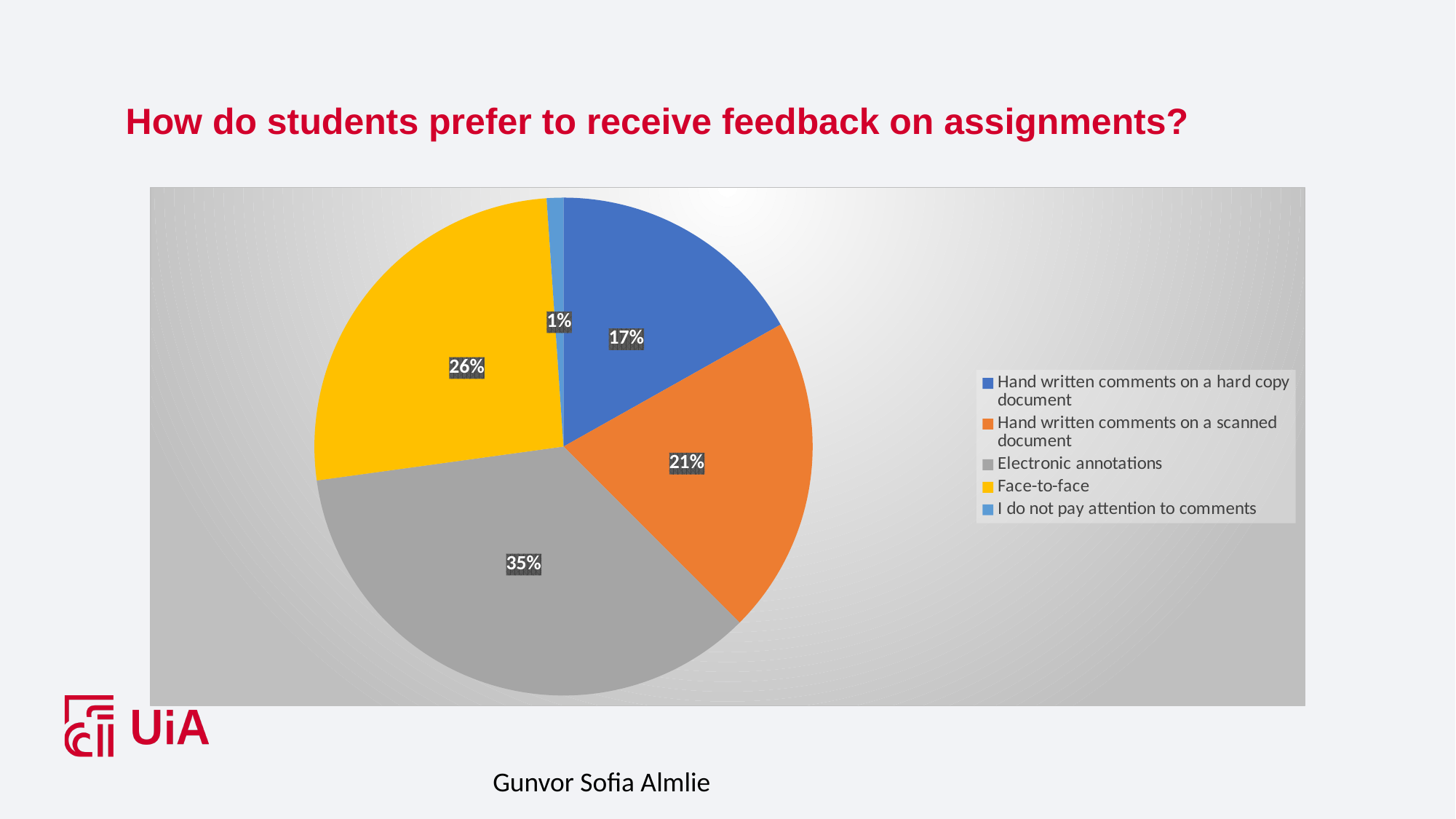
How many categories does the pie chart have? 5 What is the difference in percentage points between electronic annotations and face-to-face? 9 Which feedback option has the largest share of the pie? Electronic annotations What kind of chart is shown on the slide? pie chart Which colour represents face-to-face in the pie chart? yellow What share of students prefer hand written comments on a scanned document? 21% What share of students say they do not pay attention to comments? 1% Which feedback option has the smallest share of the pie? I do not pay attention to comments Which is larger: the share for hand written comments on a scanned document or the share for hand written comments on a hard copy document? Hand written comments on a scanned document What share of students prefer hand written comments on a hard copy document? 17% What share of students prefer face-to-face feedback? 26% What share of students prefer electronic annotations? 35%